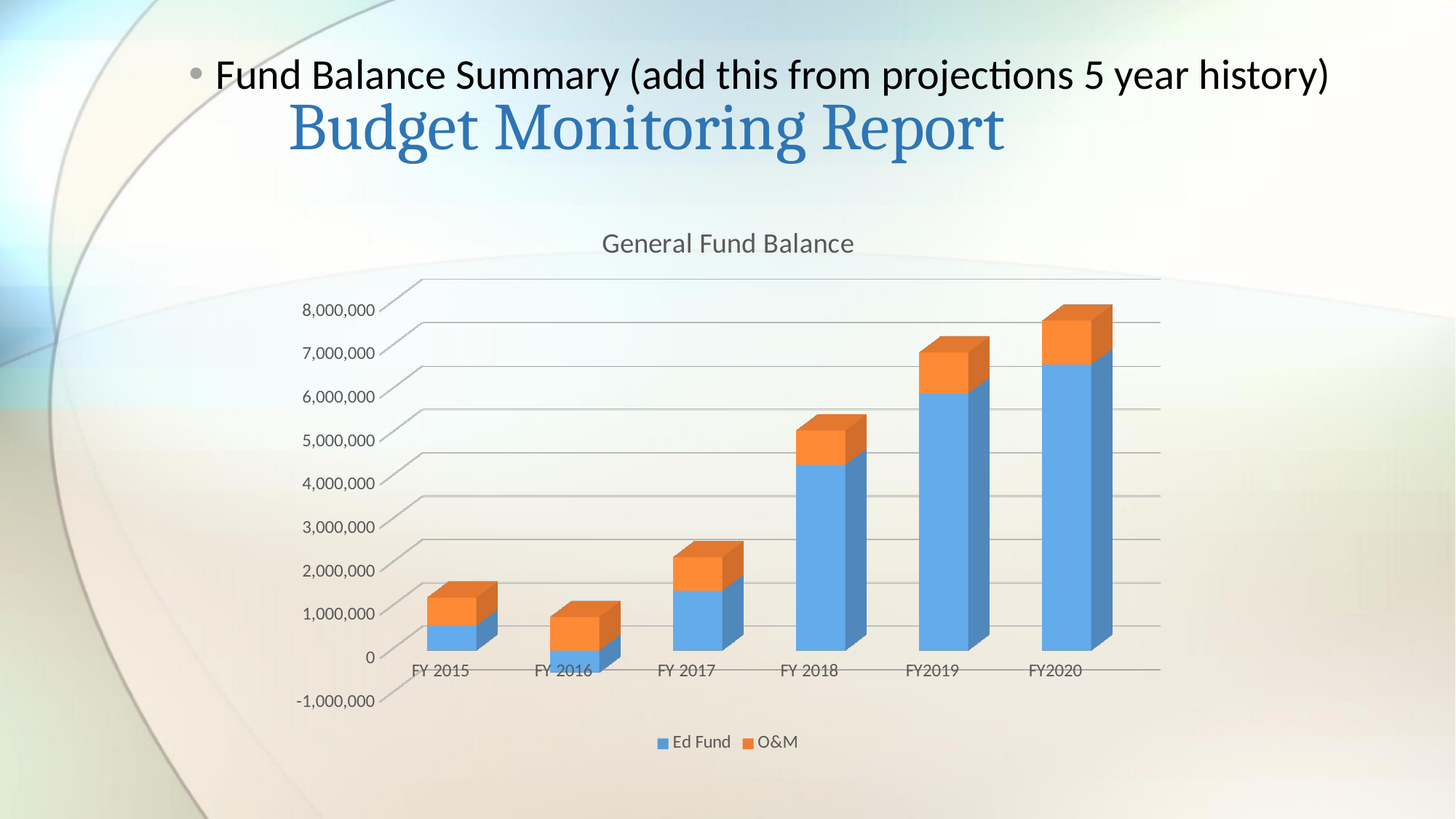
Which is larger, the Ed Fund value for FY2020 or the Ed Fund value for FY 2017? FY2020 What kind of chart is shown under the title 'General Fund Balance'? Stacked bar chart Is the Ed Fund value for FY 2016 greater or less than 0? less Is the total General Fund Balance for FY2020 greater or less than 8,000,000? less Which fiscal year has the lowest total General Fund Balance? FY 2016 How many series does the legend of the General Fund Balance chart list? 2 From FY 2016 to FY2020, does the total General Fund Balance rise or fall? rise Which fiscal year has the highest total General Fund Balance? FY2020 How many fiscal years are shown on the x axis of the General Fund Balance chart? 6 Is the Ed Fund value for FY2020 greater or less than 6,000,000? greater Which series is shown in orange in the General Fund Balance chart? O&M